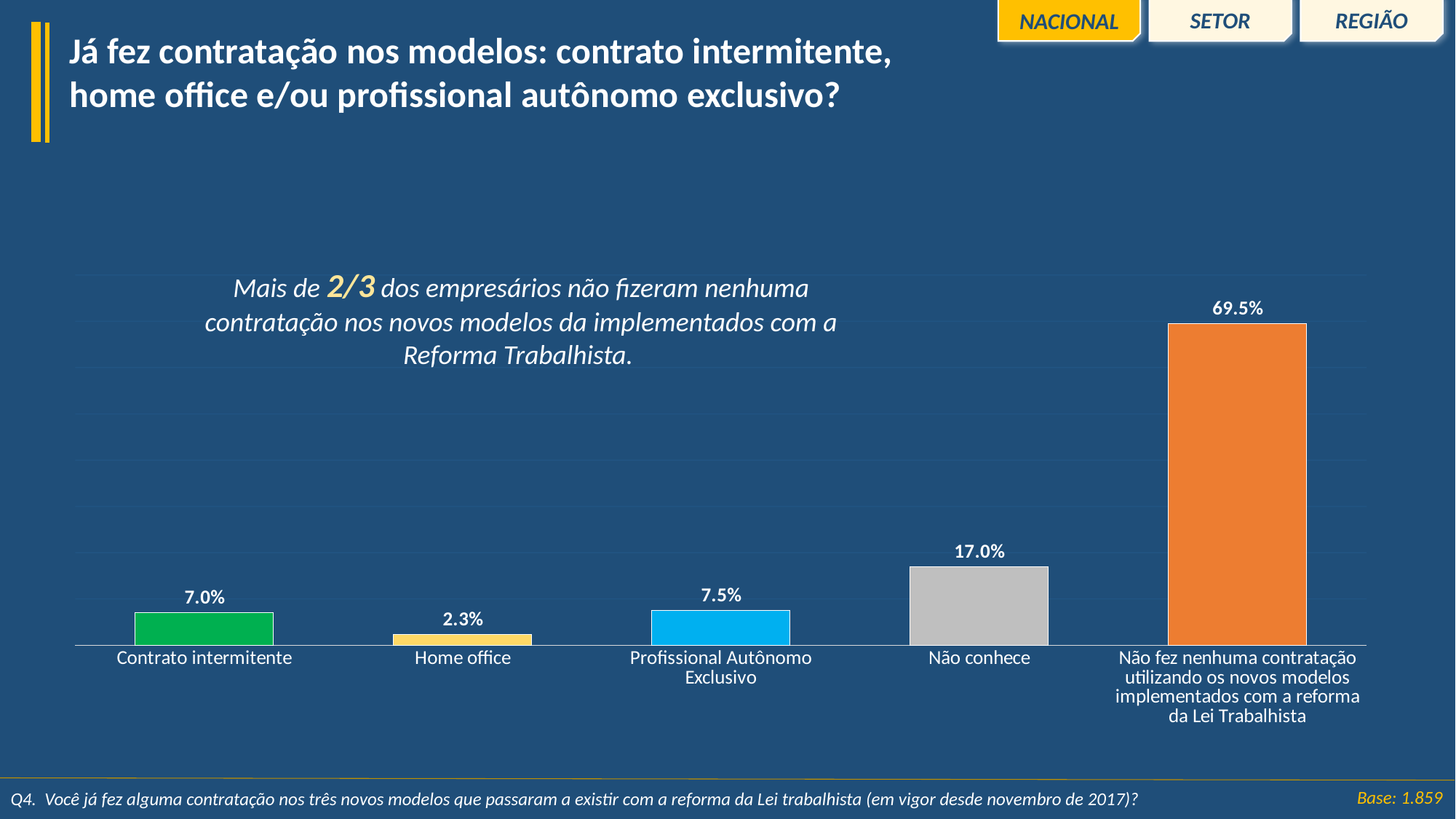
What is the value for Home office? 2.3% What kind of chart is shown on the slide? Bar chart What is the value for Profissional Autônomo Exclusivo? 7.5% What is the difference between the highest and lowest values in the chart? 67.2% Which category has the lowest value? Home office What is the value for Não conhece? 17.0% Which is larger, the value for Profissional Autônomo Exclusivo or the value for Contrato intermitente? Profissional Autônomo Exclusivo Which category has the highest value? Não fez nenhuma contratação utilizando os novos modelos implementados com a reforma da Lei Trabalhista What colour is the bar for Não conhece? Grey What is the value for Contrato intermitente? 7.0% How many categories are shown in the chart? 5 What is the difference between the values for Não conhece and Contrato intermitente? 10.0%